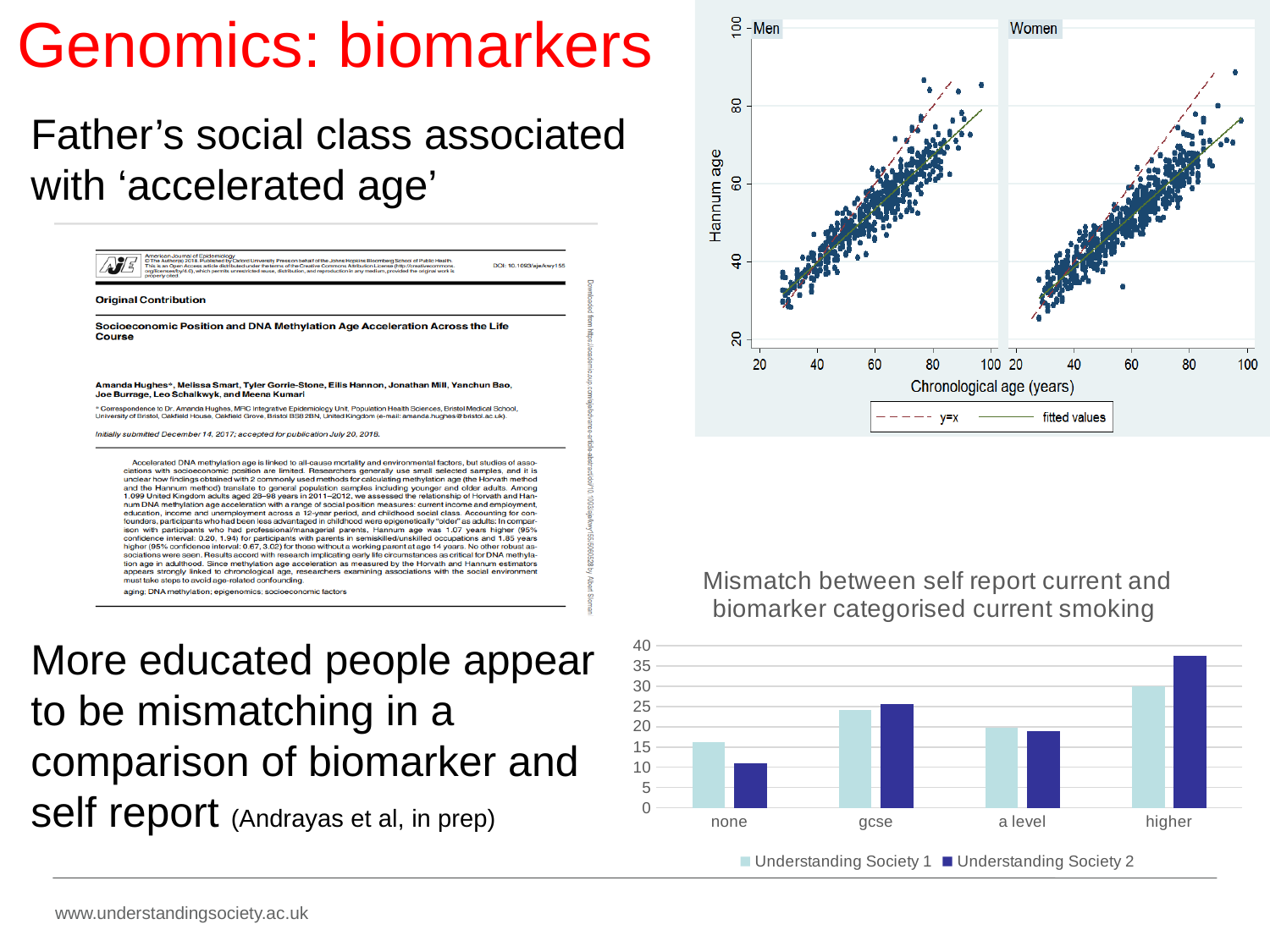
In the bar chart titled 'Mismatch between self report current and biomarker categorised current smoking', is the Understanding Society 2 value for 'none' greater or less than 15? less In the scatter plot at the top right of the slide, what is the label on the y axis? Hannum age In the bar chart titled 'Mismatch between self report current and biomarker categorised current smoking', what kind of chart is it? bar chart In the scatter plot at the top right of the slide, does Hannum age rise or fall as chronological age increases? rise In the bar chart titled 'Mismatch between self report current and biomarker categorised current smoking', how many series does the legend list? 2 In the bar chart titled 'Mismatch between self report current and biomarker categorised current smoking', for the 'none' category, which series has the larger value, Understanding Society 1 or Understanding Society 2? Understanding Society 1 In the scatter plot at the top right of the slide, what two lines does the legend list? y=x and fitted values In the bar chart titled 'Mismatch between self report current and biomarker categorised current smoking', how many categories are shown on the x axis? 4 In the bar chart titled 'Mismatch between self report current and biomarker categorised current smoking', for the 'higher' category, which series has the larger value, Understanding Society 1 or Understanding Society 2? Understanding Society 2 In the bar chart titled 'Mismatch between self report current and biomarker categorised current smoking', is the Understanding Society 2 value for 'higher' greater or less than 35? greater In the bar chart titled 'Mismatch between self report current and biomarker categorised current smoking', which category has the highest value for Understanding Society 2? higher In the bar chart titled 'Mismatch between self report current and biomarker categorised current smoking', which category has the lowest value for Understanding Society 2? none